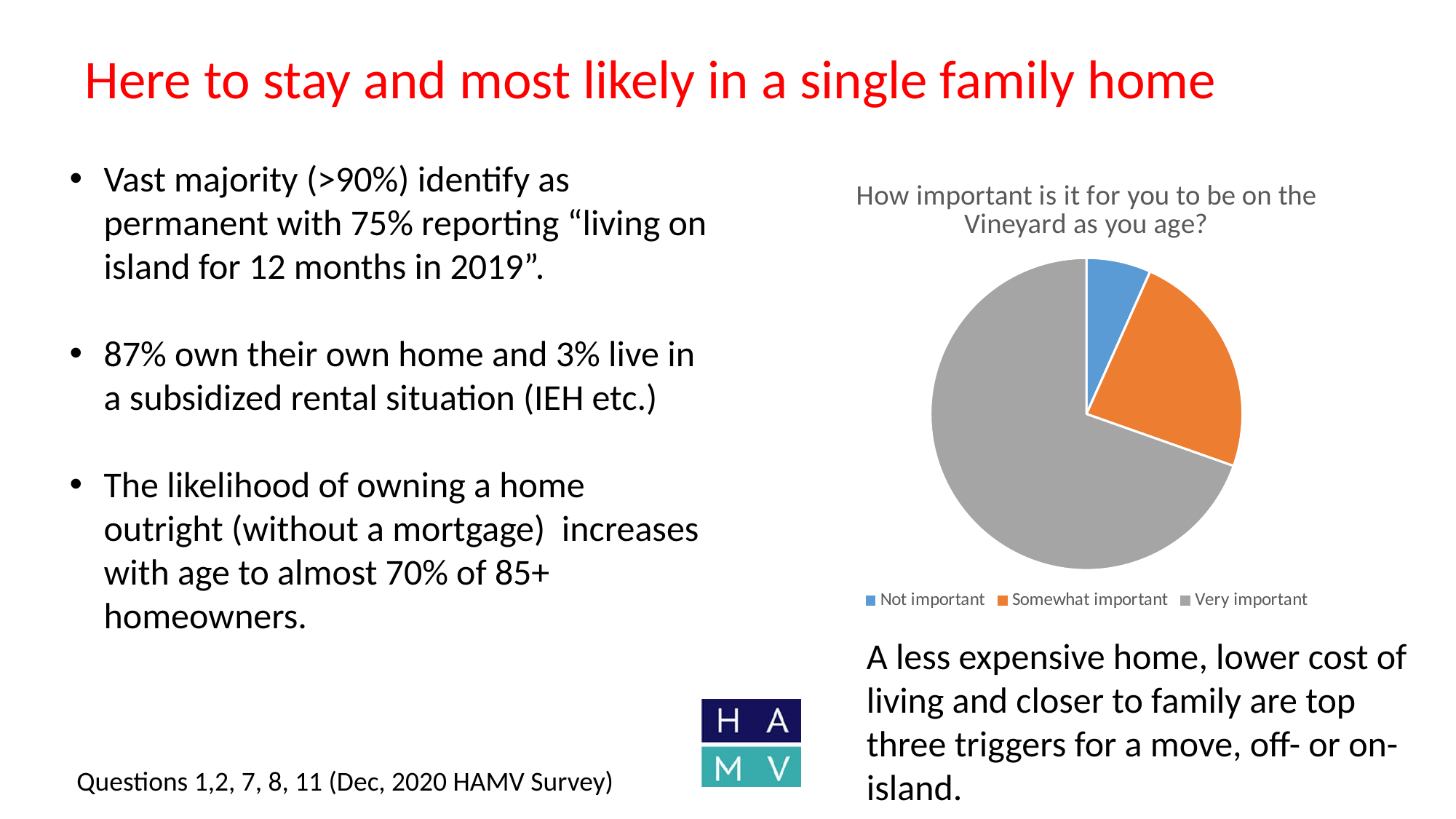
What is the title of the pie chart? How important is it for you to be on the Vineyard as you age? Which category has the largest slice in the pie chart? Very important How many entries does the legend of the pie chart list? 3 How many categories does the pie chart show? 3 Which category has the smallest slice in the pie chart? Not important Which slice is larger in the pie chart, Very important or Somewhat important? Very important Which slice is larger in the pie chart, Somewhat important or Not important? Somewhat important What kind of chart is shown on the slide? Pie chart What colour is the Very important slice in the pie chart? Gray